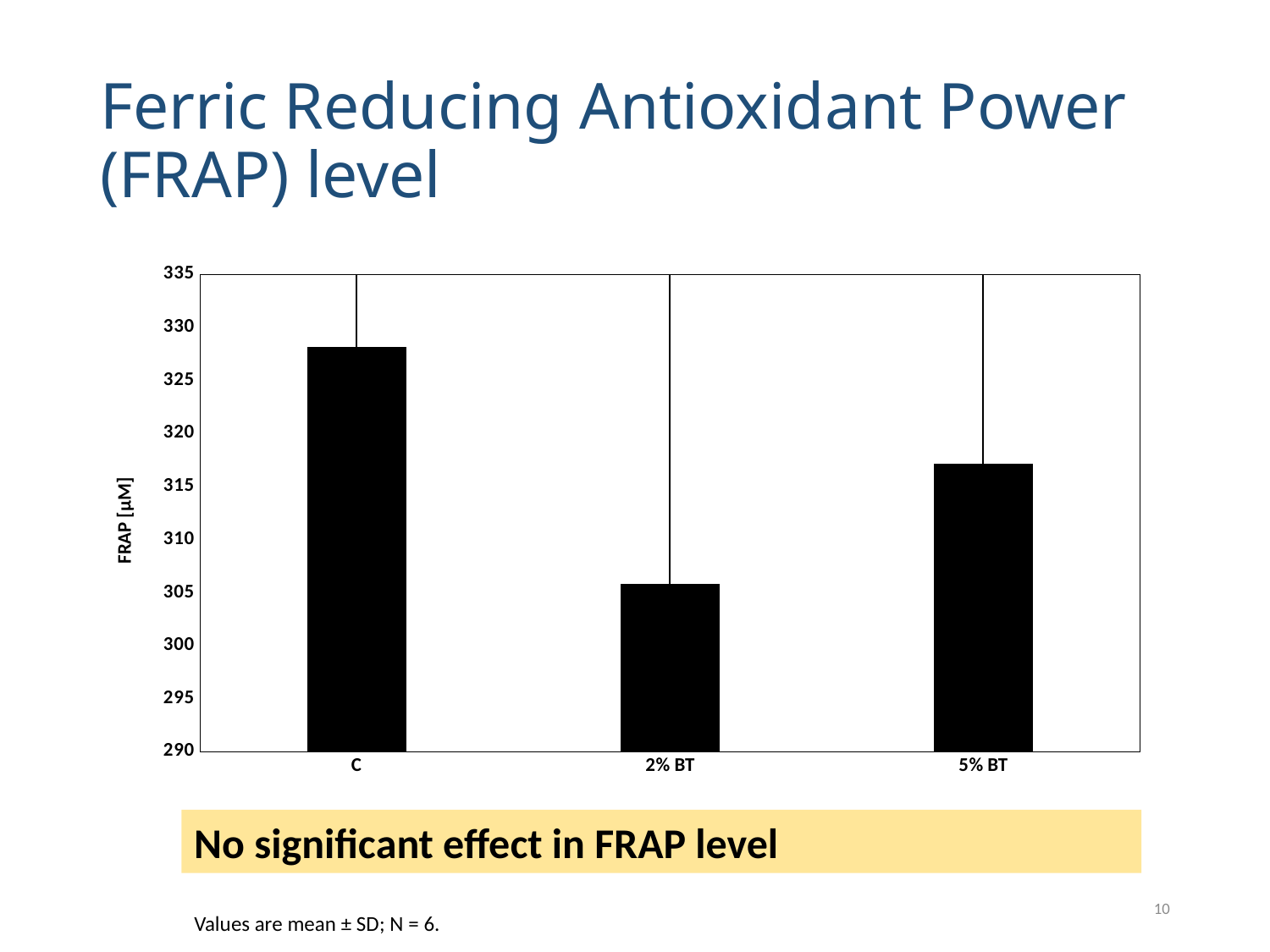
Which has a higher FRAP value, C or 5% BT? C How many categories are shown on the x axis of the chart? 3 Which has a higher FRAP value, 2% BT or 5% BT? 5% BT What kind of chart is shown on the slide? bar chart Is the value for 5% BT greater or less than 320? less Which category has the highest FRAP value? C Which category has the lowest FRAP value? 2% BT What is the lowest value shown on the y axis of the chart? 290 Is the value for 5% BT greater or less than 310? greater Is the value for C greater or less than 325? greater What is the label of the y axis of the chart? FRAP [µM]